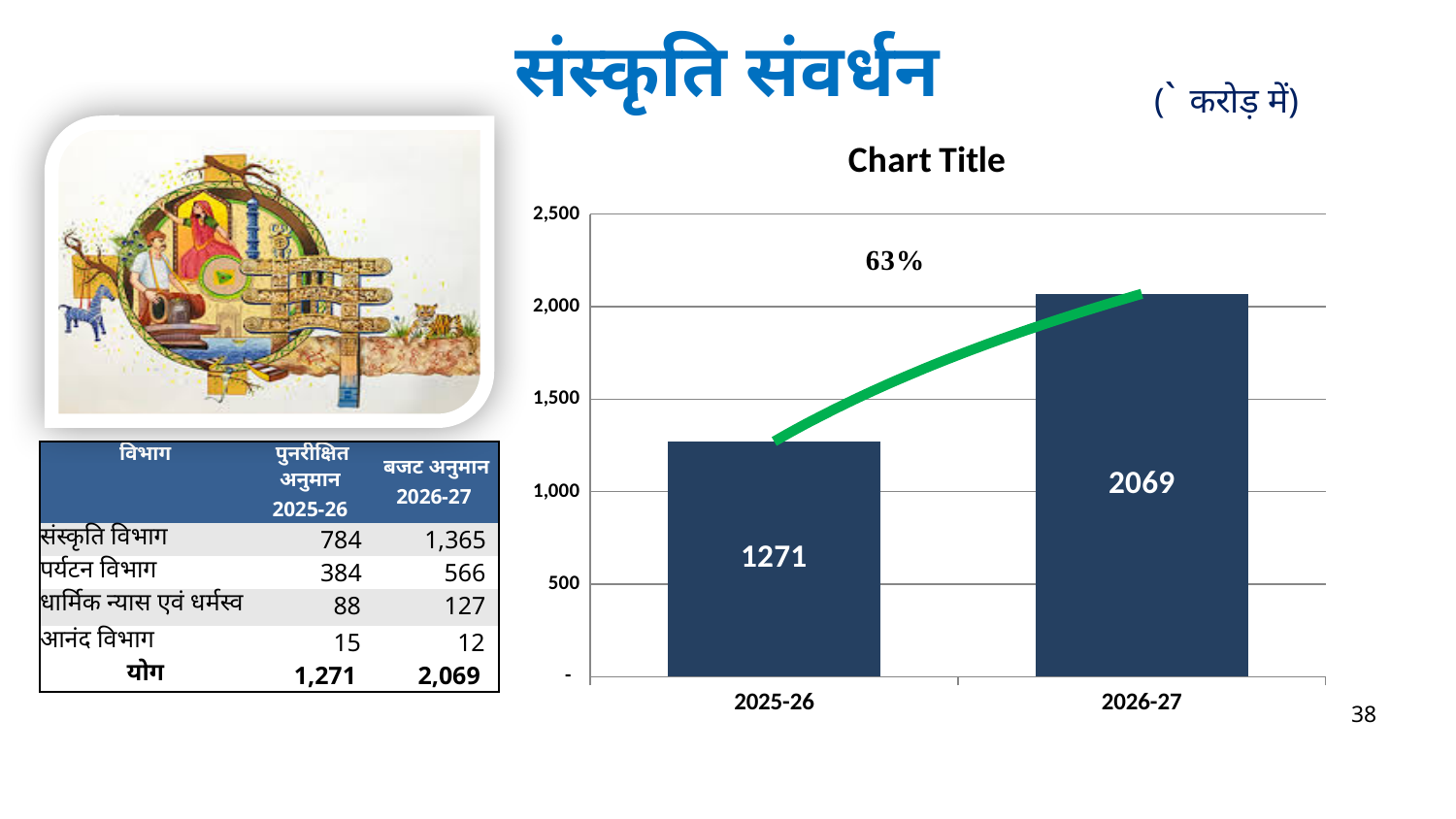
Which year has the higher value in the chart? 2026-27 Do the values rise or fall from 2025-26 to 2026-27? rise Which year has the lower value in the chart? 2025-26 What percentage is printed above the bars in the chart? 63% What kind of chart is shown on the slide? bar chart How many bars are shown in the chart? 2 Is the value for 2025-26 greater or less than 1,500? less Is the value for 2026-27 greater or less than 2,000? greater What is the difference between the 2026-27 and 2025-26 values in the chart? 798 What is the value for 2026-27 in the chart? 2069 Is the value for 2026-27 larger or smaller than the value for 2025-26? larger What is the value for 2025-26 in the chart? 1271